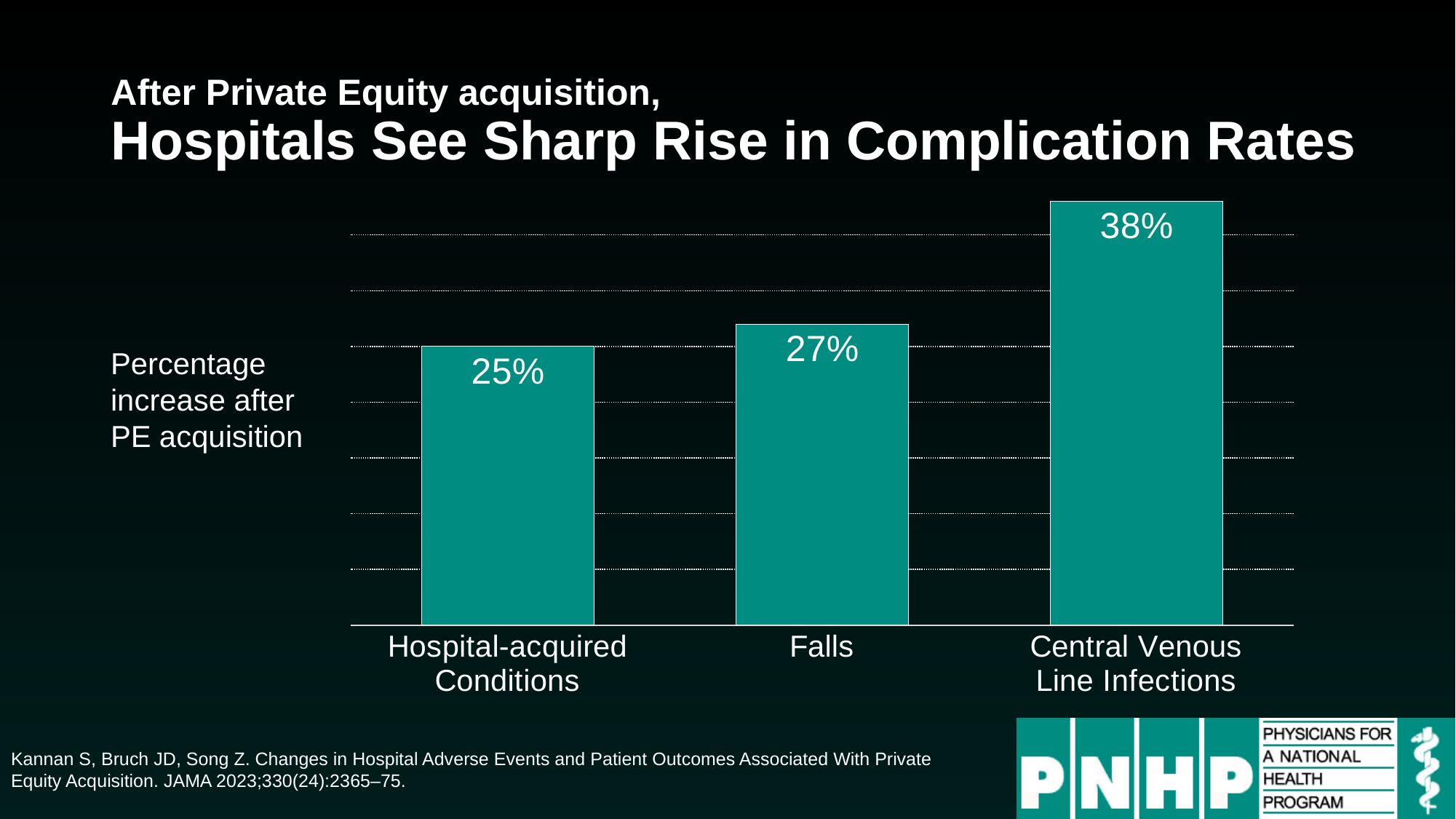
What is the percentage increase after PE acquisition for Central Venous Line Infections? 38% Do the values rise or fall moving from left to right across the categories? Rise What kind of chart is shown on the slide? Bar chart What does the label to the left of the chart say the values represent? Percentage increase after PE acquisition What is the difference in percentage points between the increase for Falls and the increase for Hospital-acquired Conditions? 2 What is the percentage increase after PE acquisition for Falls? 27% Which has a larger percentage increase after PE acquisition, Falls or Central Venous Line Infections? Central Venous Line Infections Which category shows the lowest percentage increase after PE acquisition? Hospital-acquired Conditions Which category shows the highest percentage increase after PE acquisition? Central Venous Line Infections What is the percentage increase after PE acquisition for Hospital-acquired Conditions? 25% How many categories are shown in the chart? 3 What is the difference in percentage points between the increase for Central Venous Line Infections and the increase for Hospital-acquired Conditions? 13